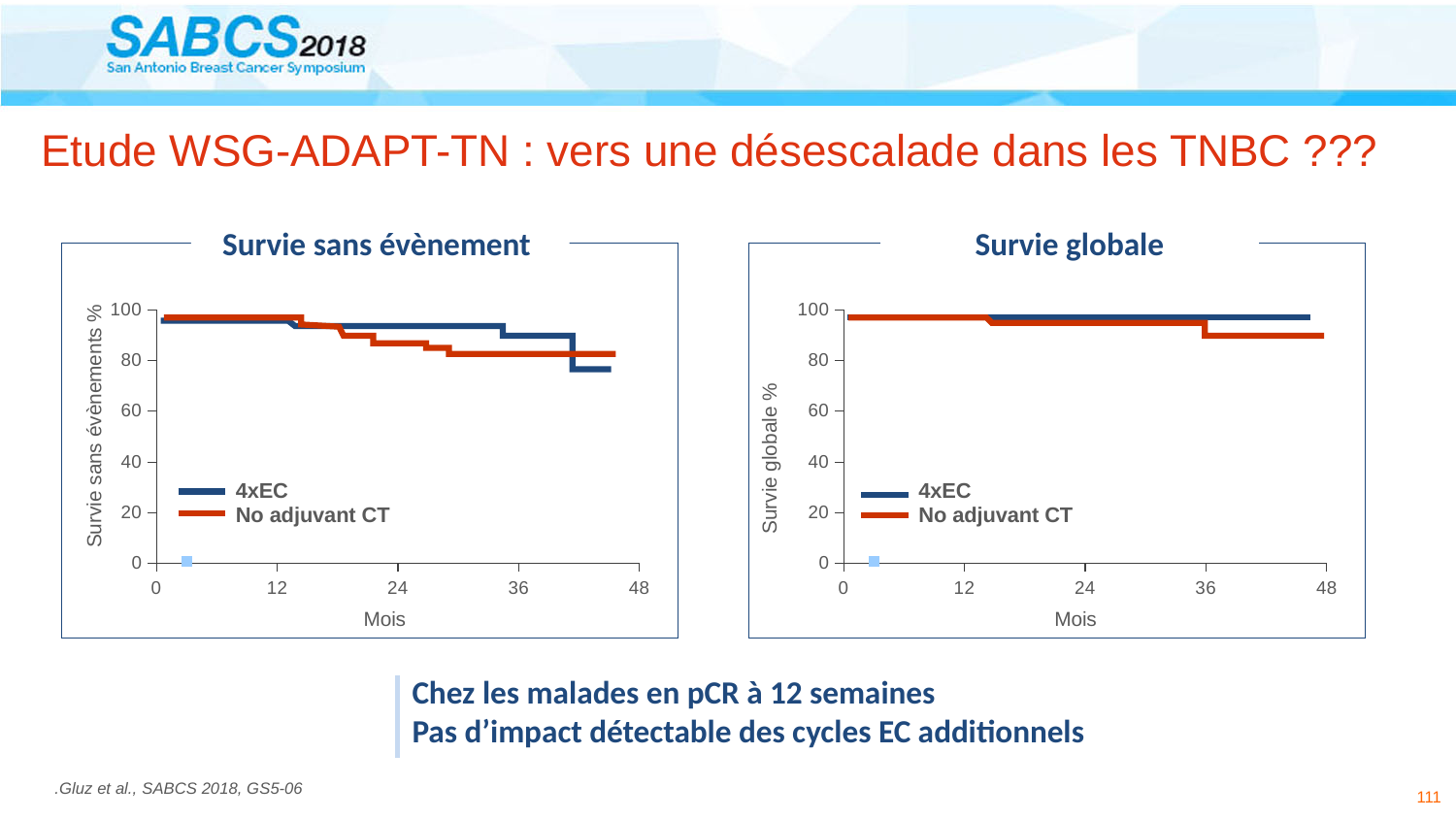
In the "Survie sans évènement" chart, which series has the higher value at 24 months, 4xEC or No adjuvant CT? 4xEC What kind of chart is the "Survie sans évènement" chart? line chart In the "Survie globale" chart, which series has the higher value at 40 months, 4xEC or No adjuvant CT? 4xEC In the "Survie sans évènement" chart, do the values for No adjuvant CT rise or fall as months increase? fall What are the two series named in the legend of the "Survie sans évènement" chart? 4xEC and No adjuvant CT How many series does the legend of the "Survie globale" chart list? 2 In the "Survie globale" chart, is the value for 4xEC at 24 months greater or less than 60? greater In the "Survie sans évènement" chart, which series is drawn in red? No adjuvant CT In the "Survie sans évènement" chart, is the value for No adjuvant CT at 12 months greater or less than 80? greater In the "Survie globale" chart, is the value for No adjuvant CT at 40 months greater or less than 80? greater What is the highest tick value shown on the x axis of the "Survie globale" chart? 48